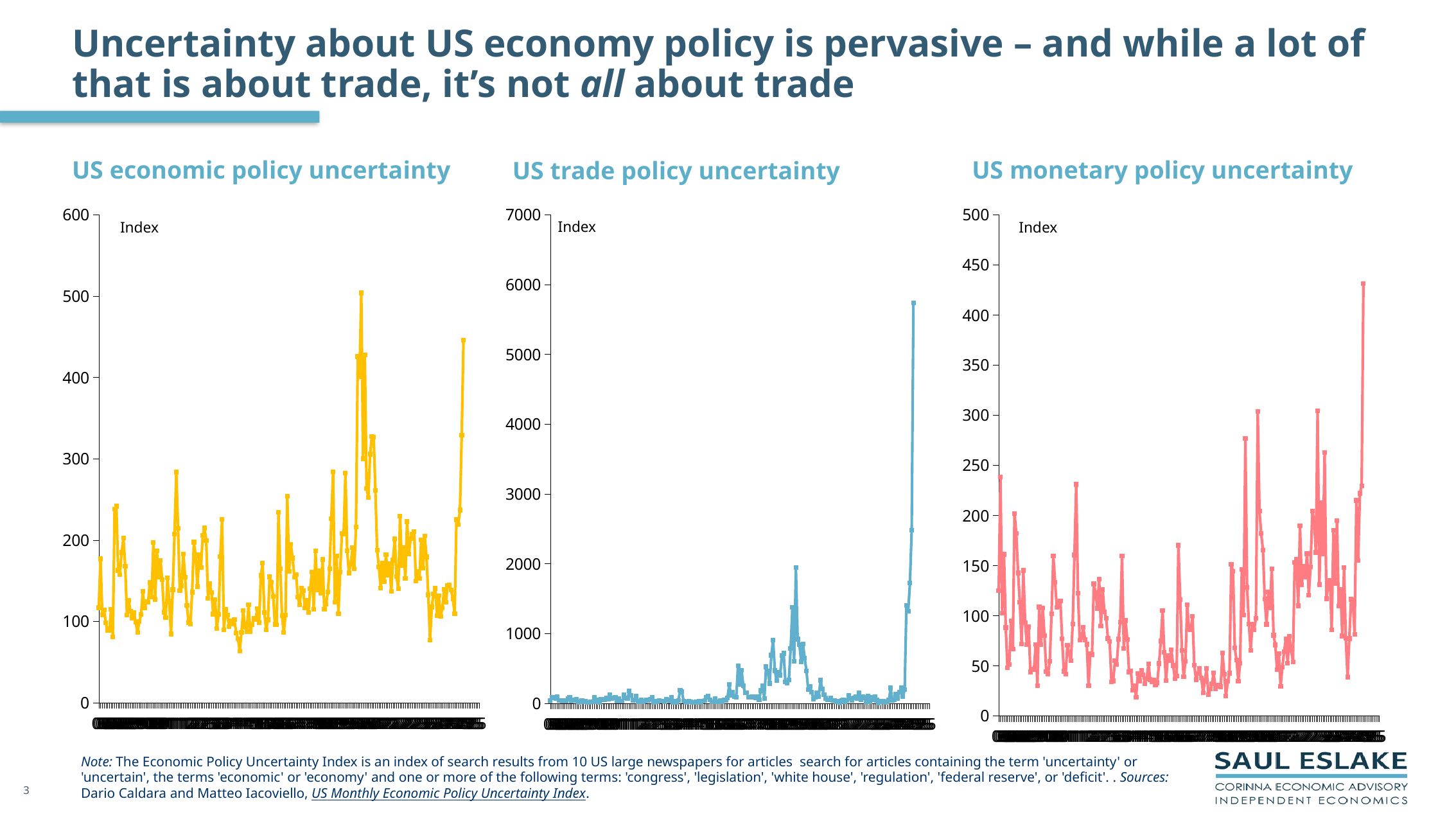
What is the top value shown on the vertical axis of the 'US trade policy uncertainty' chart? 7000 In the 'US monetary policy uncertainty' chart, is the highest value on the line greater or less than 400? greater In the 'US trade policy uncertainty' chart, is the highest value on the line greater or less than 5000? greater In the 'US trade policy uncertainty' chart, is the peak in the middle of the series greater or less than 3000? less What kind of chart is the 'US economic policy uncertainty' chart? Line chart What colour is the line in the 'US economic policy uncertainty' chart? Yellow In the 'US trade policy uncertainty' chart, does the line rise or fall sharply at the far right end of the x axis? rise In the 'US monetary policy uncertainty' chart, does the line rise or fall at the far right end of the x axis? rise What kind of chart is the 'US trade policy uncertainty' chart? Line chart